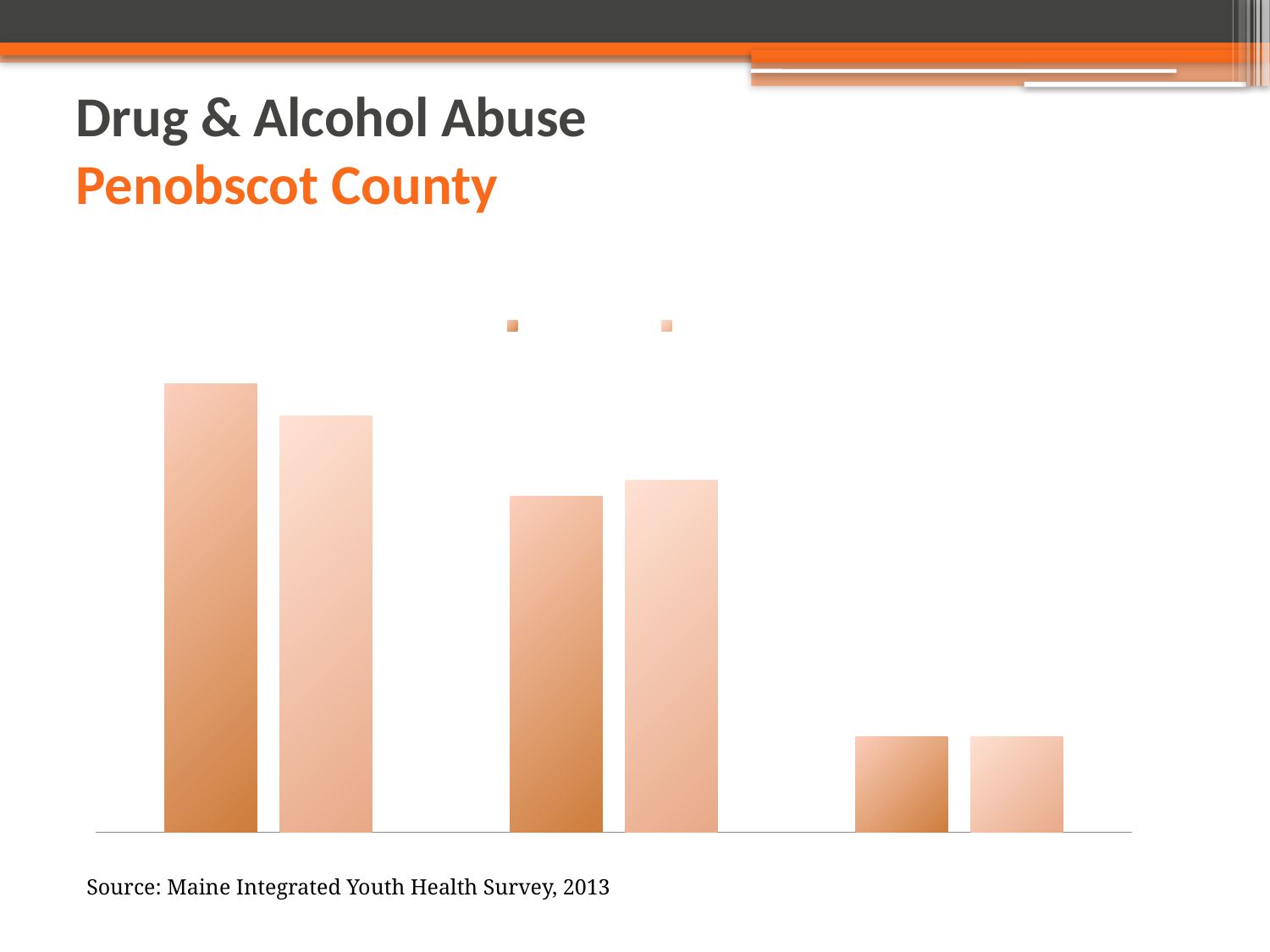
What is the source cited below the chart? Maine Integrated Youth Health Survey, 2013 Do the bar heights generally rise or fall from left to right across the chart? fall In the leftmost group, which bar is taller, the left (darker) bar or the right (lighter) bar? left (darker) bar What county does the slide title say the chart is about? Penobscot County How many bars are plotted in the chart? 6 Which group of bars is the tallest: the leftmost, middle, or rightmost group? leftmost What kind of chart is shown on the slide? bar chart In the middle group, which bar is taller, the left (darker) bar or the right (lighter) bar? right (lighter) bar How many groups of bars (categories) does the chart show? 3 Which group of bars is the shortest: the leftmost, middle, or rightmost group? rightmost How many series does the legend indicate? 2